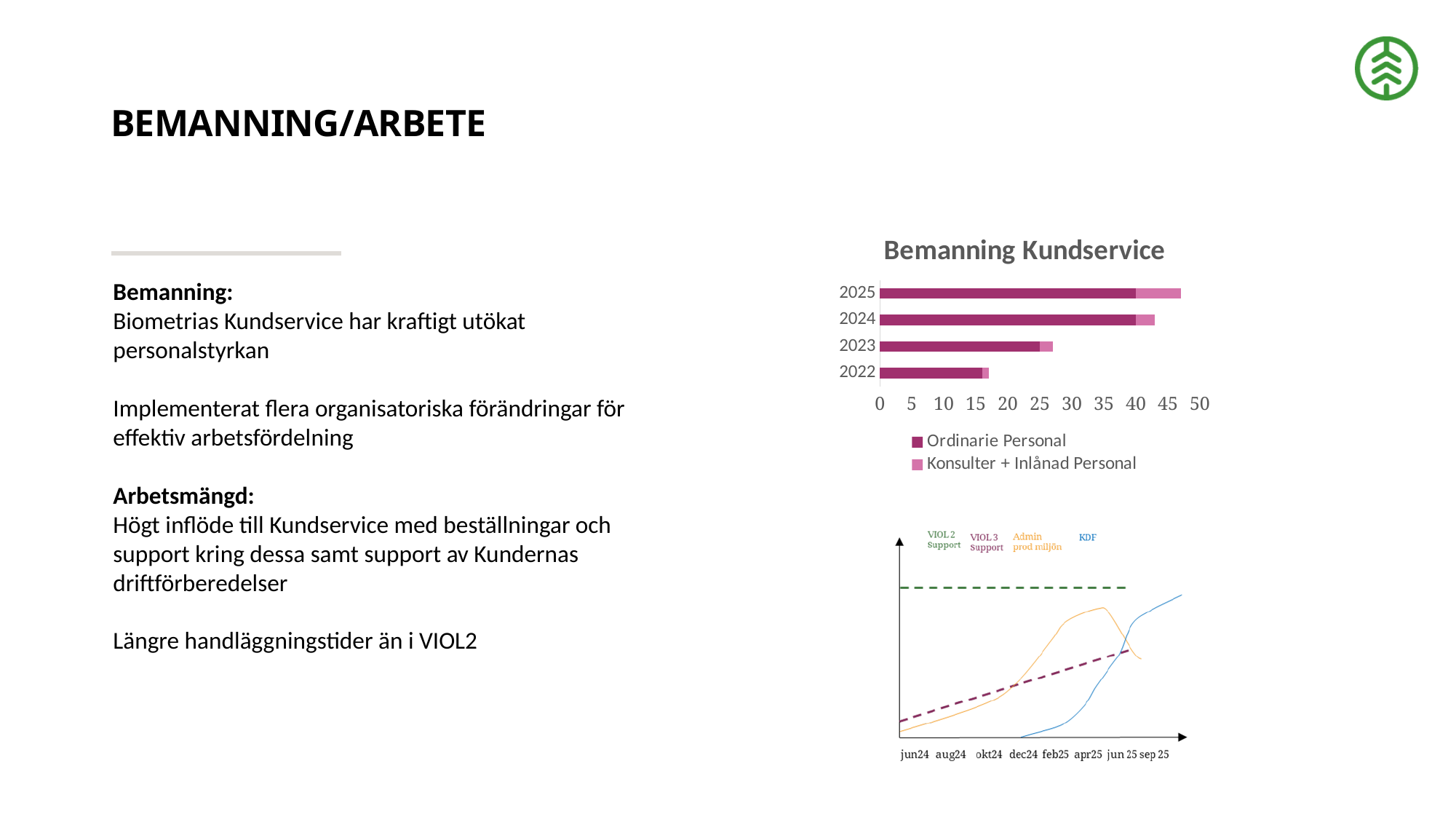
What are the two legend entries of the 'Bemanning Kundservice' chart? Ordinarie Personal; Konsulter + Inlånad Personal In the 'Bemanning Kundservice' chart, do the total bars rise or fall from 2022 to 2025? rise How many series does the legend of the 'Bemanning Kundservice' chart list? 2 In the 'Bemanning Kundservice' chart, which year has the larger Ordinarie Personal value, 2022 or 2023? 2023 In the 'Bemanning Kundservice' chart, which year has the shortest total bar? 2022 What kind of chart is the lower chart on the right of the slide, with x-axis labels from jun24 to sep 25? Line chart How many years are shown on the 'Bemanning Kundservice' chart? 4 In the 'Bemanning Kundservice' chart, is the total bar for 2025 greater or less than 45? greater In the 'Bemanning Kundservice' chart, is the Ordinarie Personal value for 2022 greater or less than 20? less In the 'Bemanning Kundservice' chart, is the total bar for 2023 greater or less than 30? less In the 'Bemanning Kundservice' chart, which year has the longest total bar? 2025 What kind of chart is the 'Bemanning Kundservice' chart? Stacked bar chart